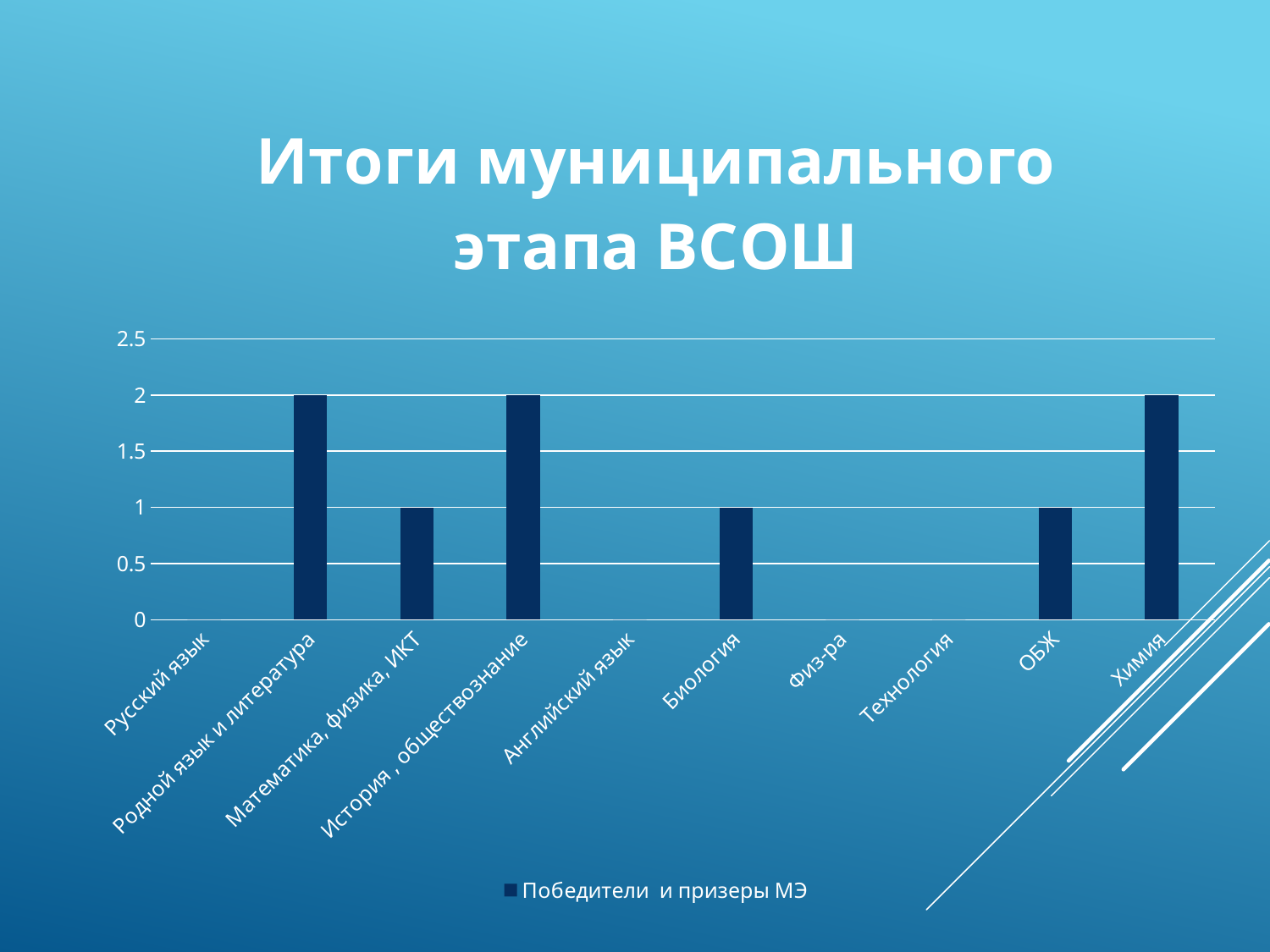
How many categories are shown on the x axis of the chart? 10 What kind of chart is shown on the slide? bar chart What is the title of the slide containing the chart? Итоги муниципального этапа ВСОШ What is the value for Математика, физика, ИКТ? 1 What is the value for Родной язык и литература? 2 What is the value for ОБЖ? 1 Which is larger, the value for История, обществознание or the value for Биология? История, обществознание How many series does the chart legend list? 1 Is the value for Биология greater or less than 1.5? less What is the value for Химия? 2 What is the series name shown in the chart legend? Победители и призеры МЭ What is the difference between the value for Химия and the value for ОБЖ? 1